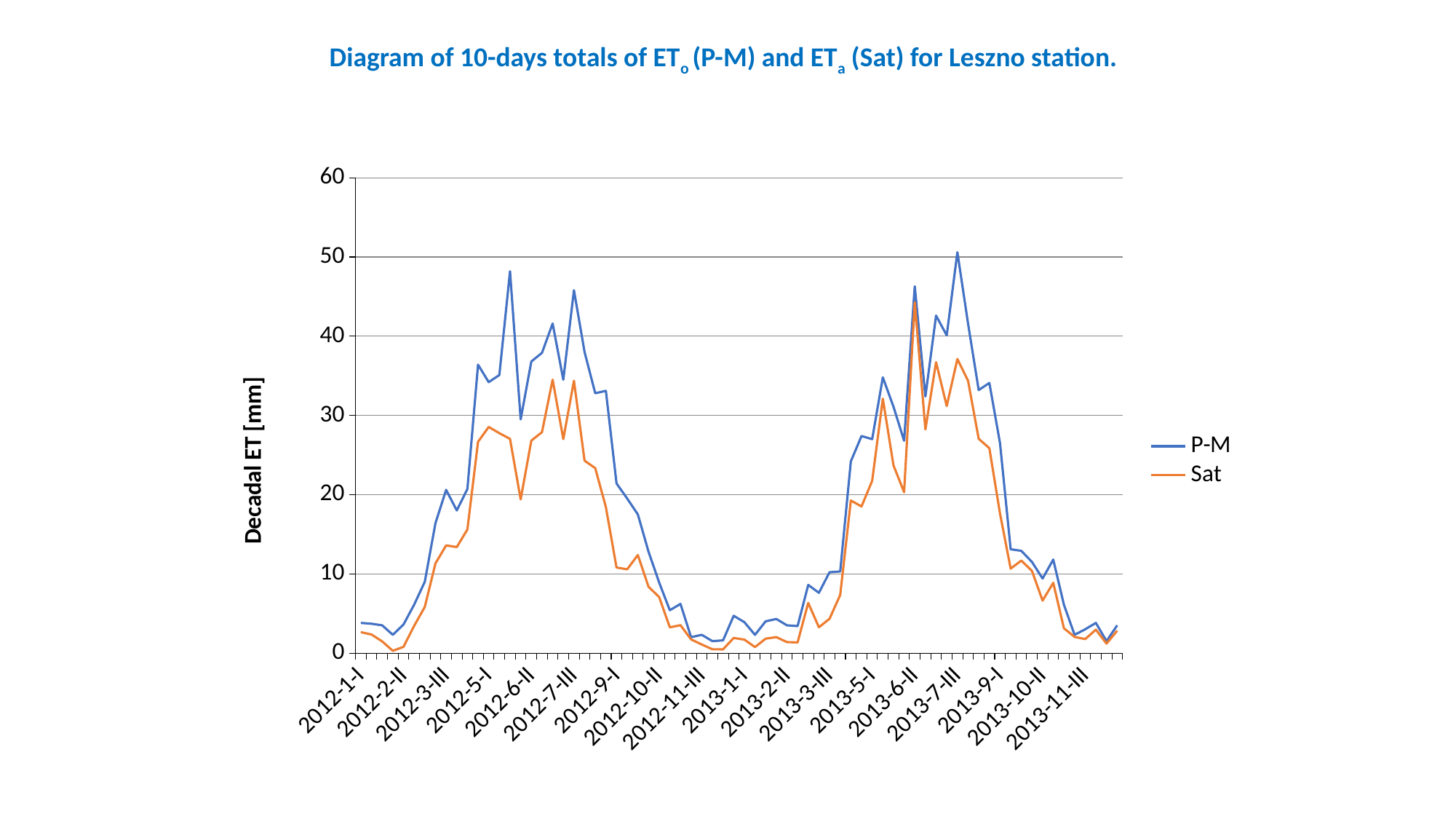
Is the Sat value at 2012-7-III greater or less than 30? greater Is the P-M value at 2013-7-III greater or less than 40? greater Which series reaches the highest peak on the chart, P-M or Sat? P-M At 2012-6-II, which series has the larger value, P-M or Sat? P-M Is the P-M value at 2012-7-III greater or less than 40? greater What kind of chart is shown on the slide? line chart What is the label of the vertical axis? Decadal ET [mm] What are the two series named in the legend? P-M and Sat How many series does the legend list? 2 Do the P-M values rise or fall between 2012-7-III and 2012-11-III? fall